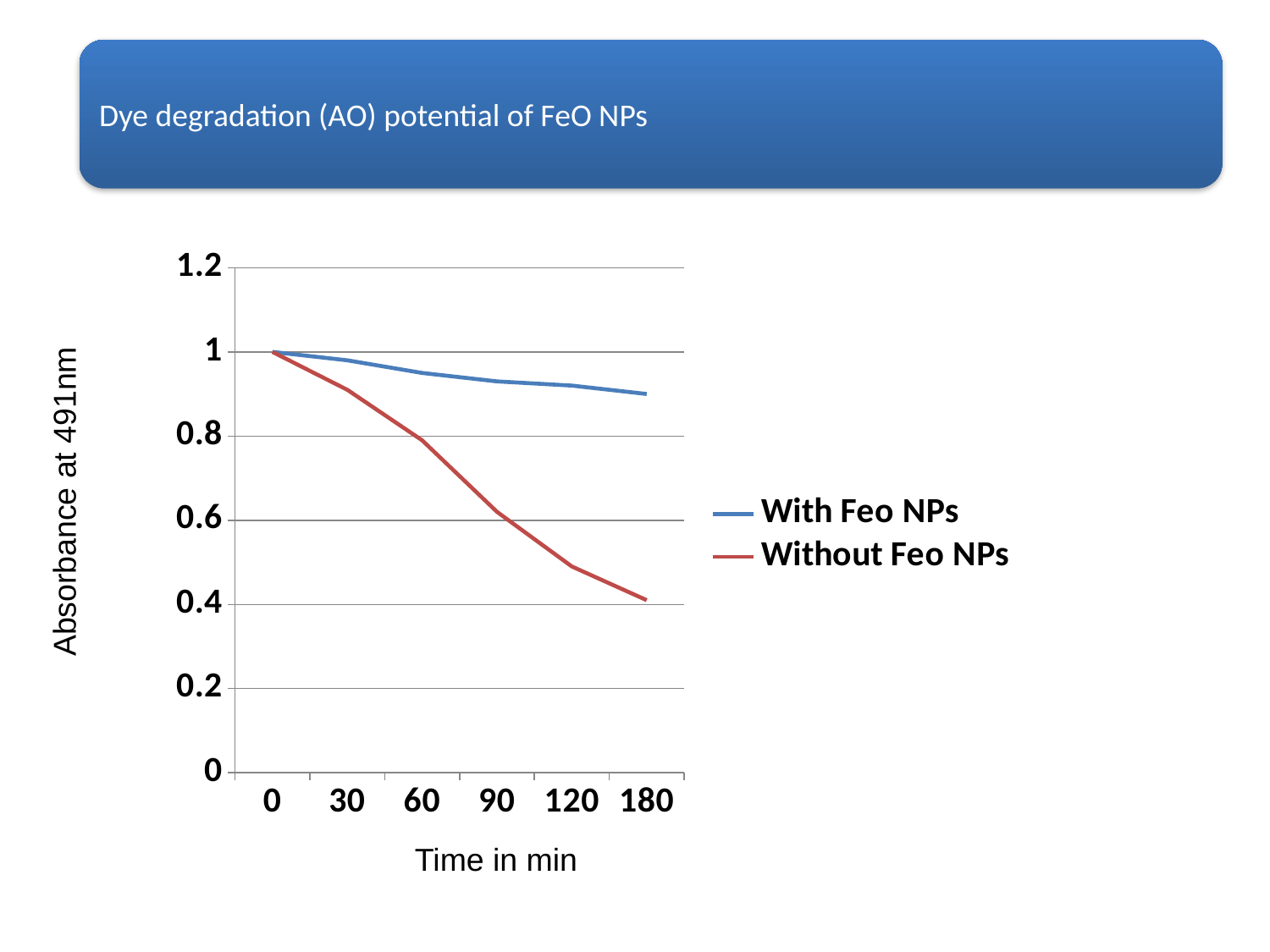
What is the label of the y axis? Absorbance at 491nm Does the absorbance for 'With Feo NPs' rise or fall as time increases? fall Is the absorbance for 'With Feo NPs' at 180 min greater or less than 0.8? greater Is the absorbance for 'Without Feo NPs' at 120 min greater or less than 0.6? less What is the absorbance for 'With Feo NPs' at time 0? 1 How many series does the legend list? 2 Is the absorbance for 'Without Feo NPs' at 180 min greater or less than 0.6? less What kind of chart is shown on the slide? line chart How many time points are plotted along the x axis? 6 At 180 min, which series has the higher absorbance, 'With Feo NPs' or 'Without Feo NPs'? With Feo NPs Does the absorbance for 'Without Feo NPs' rise or fall as time increases? fall What is the absorbance for 'Without Feo NPs' at time 0? 1